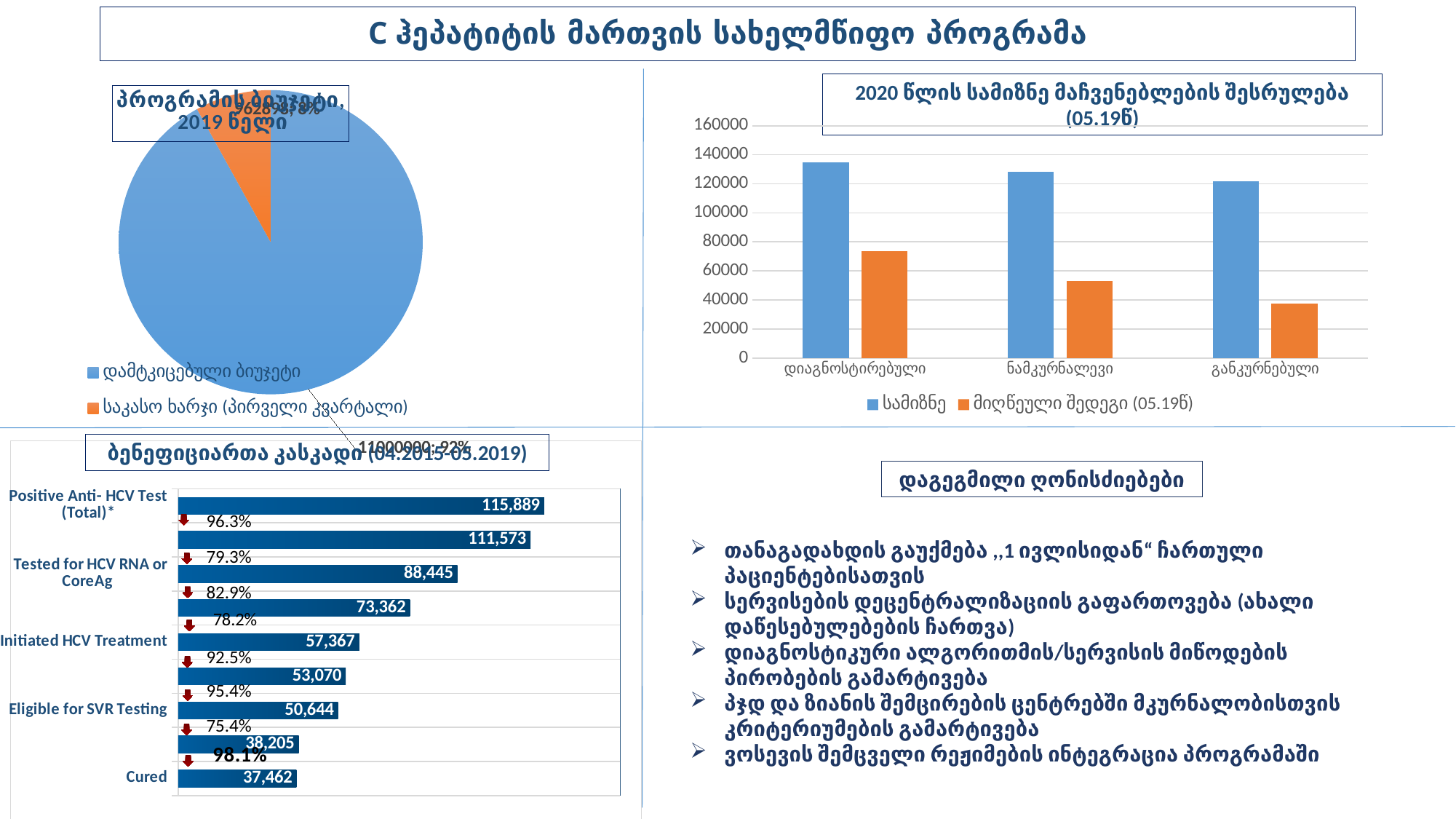
In the bottom-left cascade chart, what is the value of the Cured bar? 37,462 In the bottom-left cascade chart, what percentage is shown next to the arrow just above the Cured bar? 98.1% In the bottom-left cascade chart, what is the value of the longest bar (Positive Anti-HCV Test (Total)*)? 115,889 In the top-right chart, how many categories are on the x axis? 3 What kind of chart is the top-left chart? pie chart In the bottom-left cascade chart, how many bars are plotted? 9 In the top-right chart, is the სამიზნე value for დიაგნოსტირებული greater or less than 120000? greater In the bottom-left cascade chart, do the bar values rise or fall from top to bottom? fall In the top-right chart, how many series does the legend list? 2 In the bottom-left cascade chart, what is the difference between the first bar (115,889) and the Cured bar (37,462)? 78,427 In the top-right chart, is the მიღწეული შედეგი value for განკურნებული greater or less than 40000? less In the top-right chart, which category has the lowest მიღწეული შედეგი (orange) bar? განკურნებული